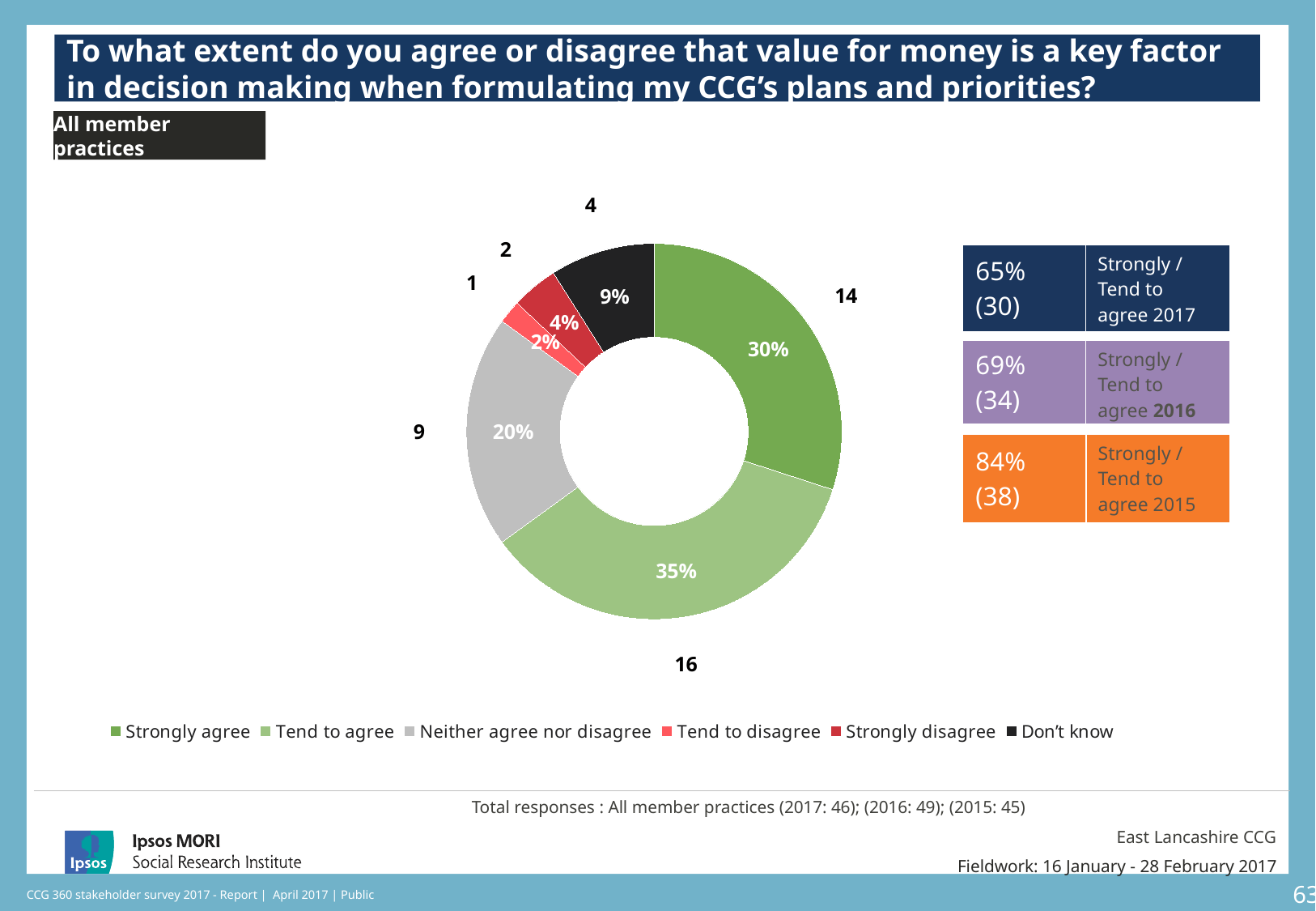
What type of chart is used on this slide? Doughnut chart How many response categories are shown in the doughnut chart? 6 What colour represents 'Neither agree nor disagree' in the chart? Grey What is the difference in percentage points between 'Tend to agree' and 'Strongly agree'? 5 What percentage of respondents said they tend to agree? 35% What percentage of respondents answered 'Don't know'? 9% Which response category has the largest share of the doughnut chart? Tend to agree What percentage of respondents said they strongly agree? 30% Which is larger: the share for 'Strongly disagree' or the share for 'Don't know'? Don't know How many respondents said they neither agree nor disagree? 9 Which response category has the smallest share of the doughnut chart? Tend to disagree What is the combined percentage of 'Strongly agree' and 'Tend to agree' for 2017, as shown in the box to the right of the chart? 65%